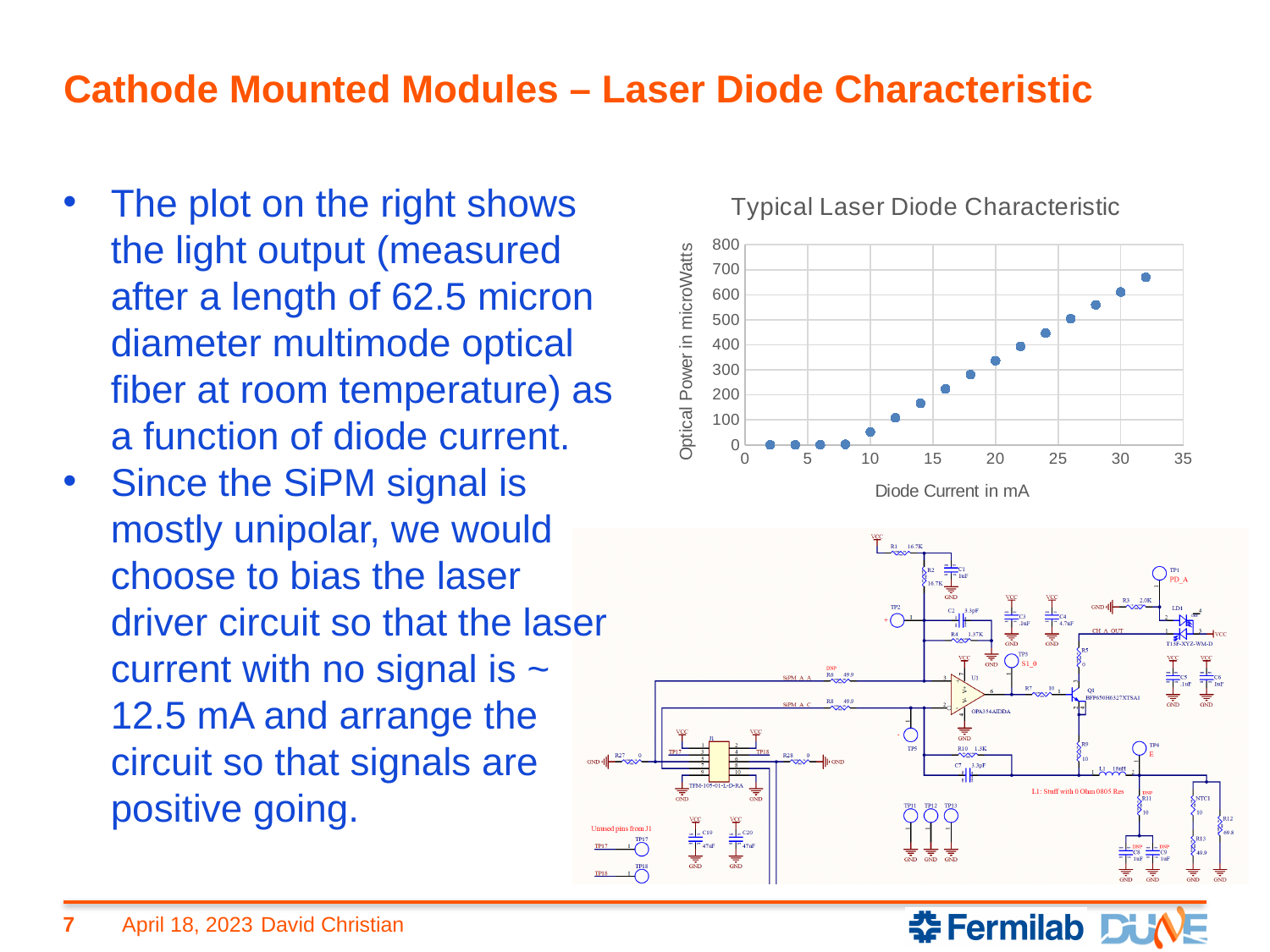
In the Typical Laser Diode Characteristic chart, is the optical power at a diode current of 30 mA greater or less than 500? greater In the Typical Laser Diode Characteristic chart, which has the higher optical power: the point at 16 mA or the point at 28 mA? 28 mA In the Typical Laser Diode Characteristic chart, is the optical power at a diode current of 14 mA greater or less than 200? less What kind of chart is the Typical Laser Diode Characteristic chart? scatter chart In the Typical Laser Diode Characteristic chart, is the optical power at a diode current of 20 mA greater or less than 300? greater How many data points are plotted in the Typical Laser Diode Characteristic chart? 16 What is the title of the chart on the slide? Typical Laser Diode Characteristic What is the label of the y axis on the Typical Laser Diode Characteristic chart? Optical Power in microWatts In the Typical Laser Diode Characteristic chart, at which diode current is the optical power highest? 32 mA In the Typical Laser Diode Characteristic chart, does the optical power rise or fall as the diode current increases? rise